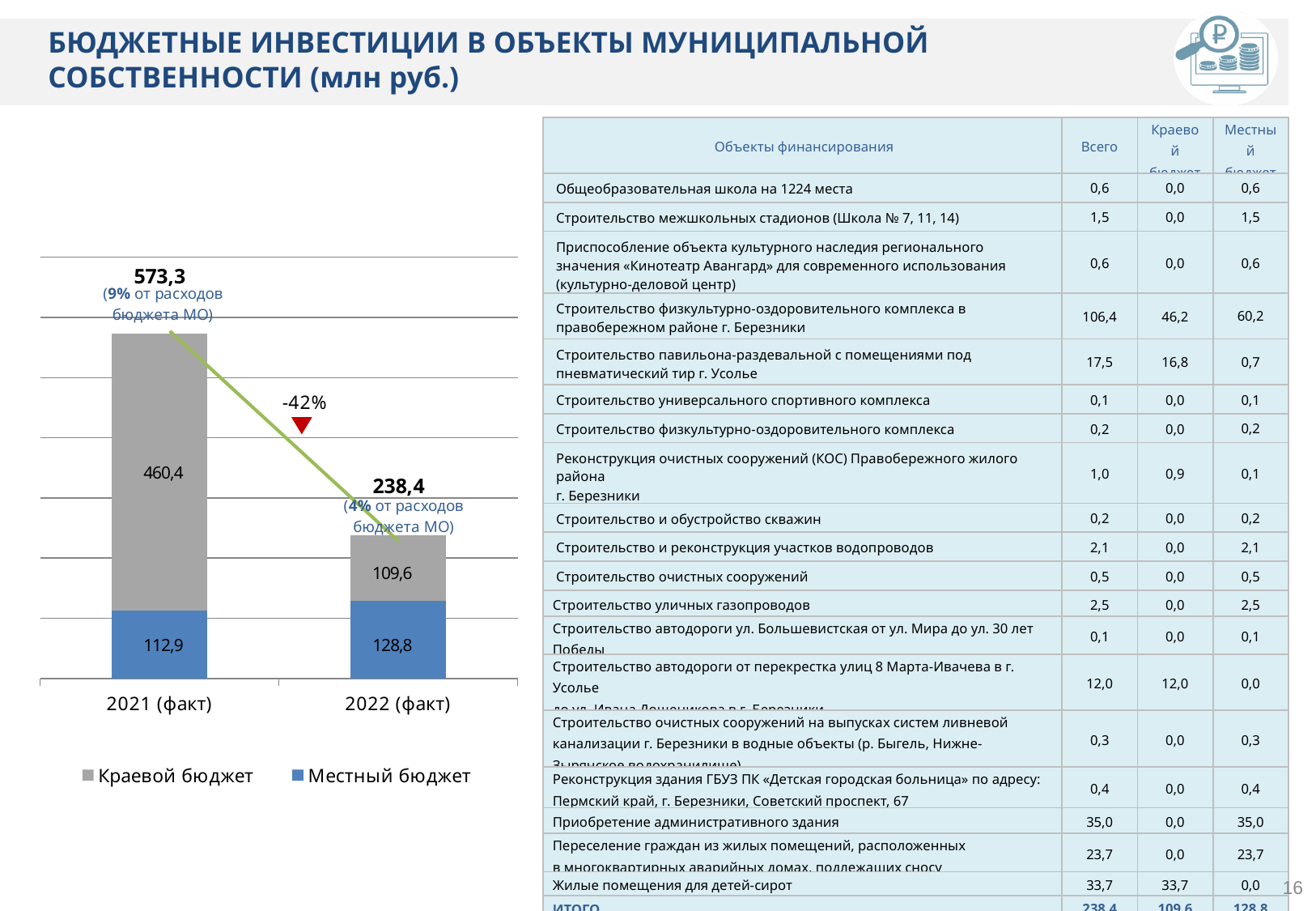
What percentage change is labelled between the 2021 and 2022 bars? -42% What is the value of Краевой бюджет for 2021 (факт)? 460,4 Which year has the higher total budget investment, 2021 (факт) or 2022 (факт)? 2021 (факт) What is the total of the stacked bar for 2021 (факт)? 573,3 How many categories are shown on the x axis of the chart? 2 What is the difference between the Краевой бюджет values for 2021 (факт) and 2022 (факт)? 350,8 Do the total values rise or fall from 2021 (факт) to 2022 (факт)? fall What is the value of Местный бюджет for 2022 (факт)? 128,8 What kind of chart is shown on the left of the slide? stacked bar chart How many series does the chart legend list? 2 What is the total of the stacked bar for 2022 (факт)? 238,4 What is the value of Краевой бюджет for 2022 (факт)? 109,6